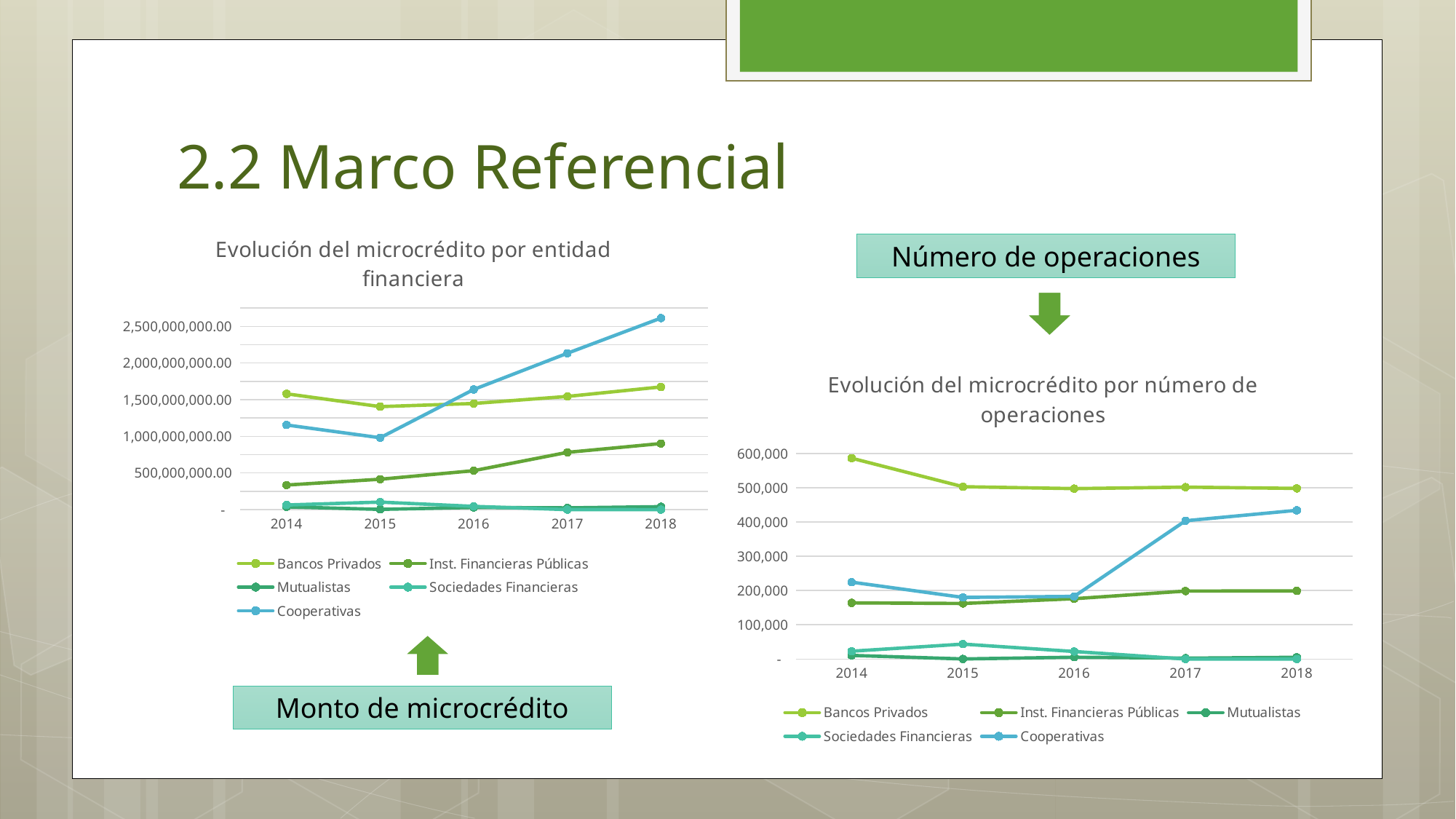
How many series does the legend of the left chart 'Evolución del microcrédito por entidad financiera' list? 5 In the right chart 'Evolución del microcrédito por número de operaciones', which series has the highest value in 2018? Bancos Privados In the right chart 'Evolución del microcrédito por número de operaciones', which is larger in 2016: Bancos Privados or Cooperativas? Bancos Privados In the right chart 'Evolución del microcrédito por número de operaciones', is the value for Bancos Privados in 2014 greater or less than 500,000? greater In the left chart 'Evolución del microcrédito por entidad financiera', do the values for Inst. Financieras Públicas rise or fall from 2014 to 2018? rise In the right chart 'Evolución del microcrédito por número de operaciones', is the value for Cooperativas in 2018 greater or less than 400,000? greater In the left chart 'Evolución del microcrédito por entidad financiera', which series has the highest value in 2014? Bancos Privados In the left chart 'Evolución del microcrédito por entidad financiera', which series has the highest value in 2018? Cooperativas What type of chart is the left chart titled 'Evolución del microcrédito por entidad financiera'? line chart In the left chart 'Evolución del microcrédito por entidad financiera', is the value for Cooperativas in 2018 greater or less than 2,500,000,000.00? greater How many years are shown on the x axis of the right chart 'Evolución del microcrédito por número de operaciones'? 5